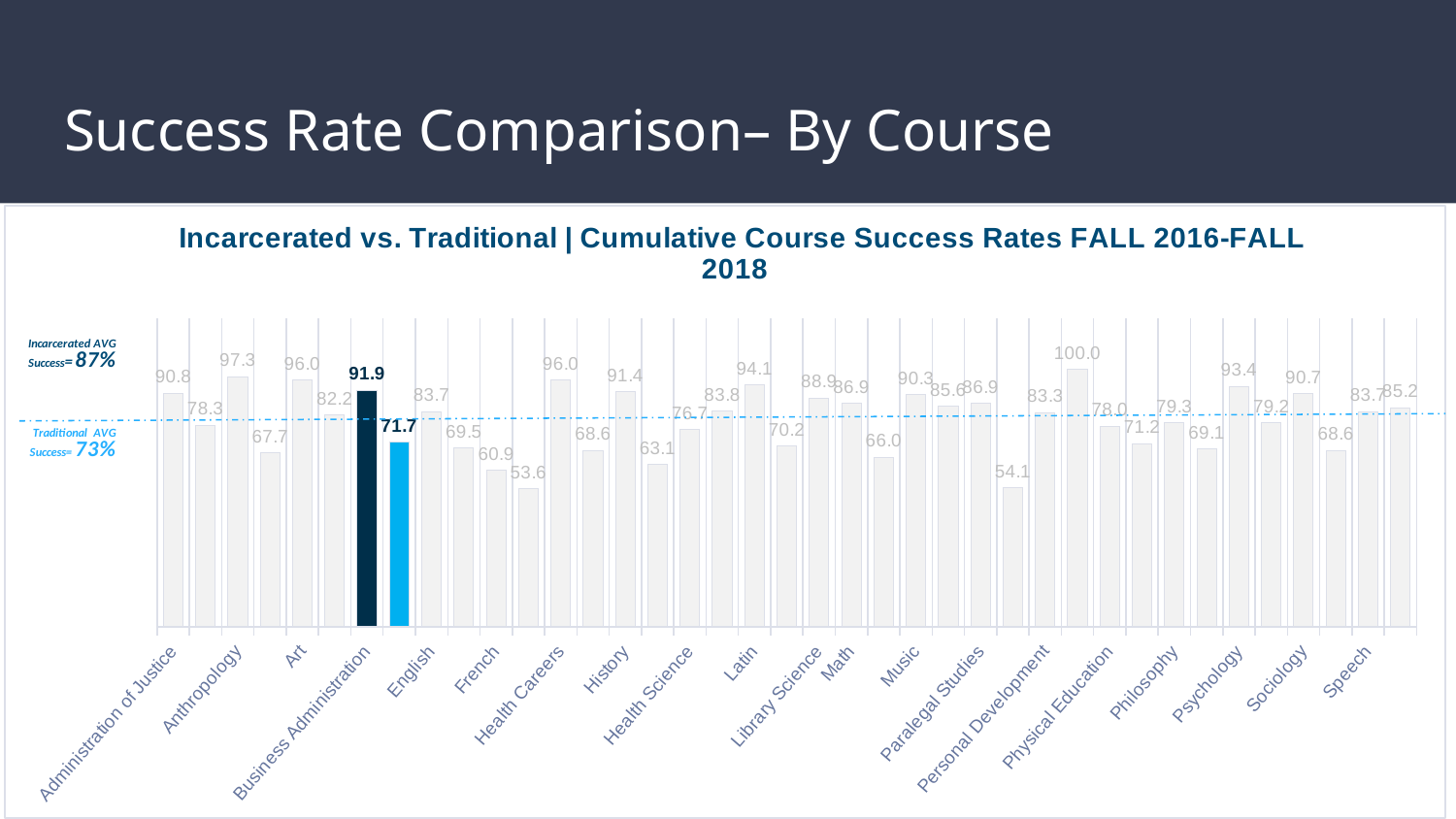
What is the difference between the two Anthropology bars (97.3 and 67.7)? 29.6 Which is larger: the first bar for Art (96.0) or the first bar for Administration of Justice (90.8)? Art What is the Traditional AVG Success rate noted on the left of the chart? 73% Which course's bars are highlighted in dark navy and bright blue? Business Administration What type of chart is shown on the slide? Bar chart Which course has the lowest bar in the chart? French What is the difference between the two Business Administration bars (91.9 and 71.7)? 20.2 What is the incarcerated success rate for Business Administration (the dark highlighted bar)? 91.9 What is the Incarcerated AVG Success rate noted on the left of the chart? 87% How many courses are listed along the x axis? 20 What is the traditional success rate for Business Administration (the light blue highlighted bar)? 71.7 What is the first (incarcerated) value shown for Anthropology? 97.3